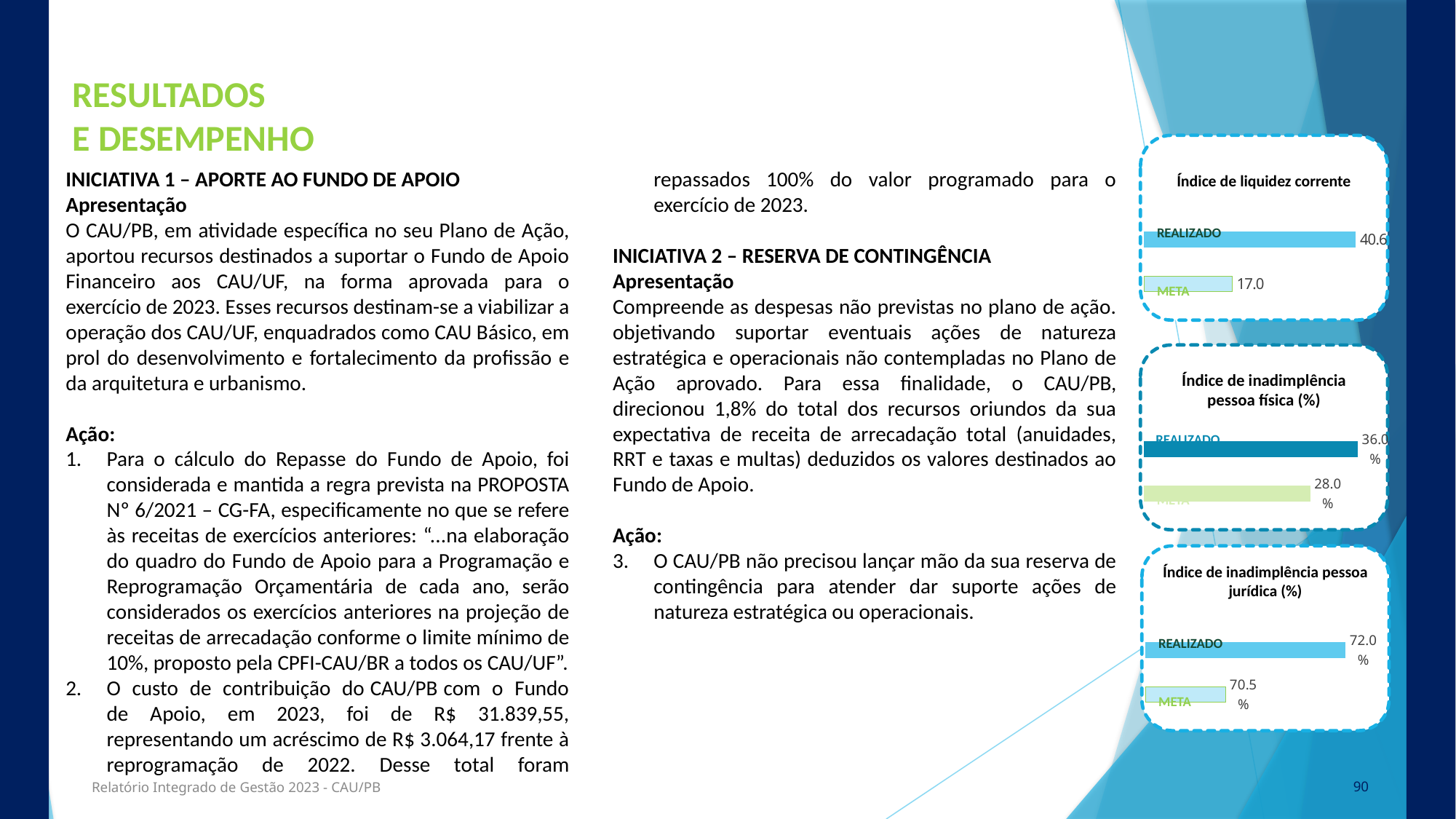
In the 'Índice de liquidez corrente' chart, what is the difference between REALIZADO and META? 23.6 In the 'Índice de inadimplência pessoa física (%)' chart, what is the value for META? 28.0% In the 'Índice de inadimplência pessoa física (%)' chart, what is the difference between REALIZADO and META? 8.0% What kind of chart is the 'Índice de liquidez corrente' chart? Bar chart In the 'Índice de inadimplência pessoa jurídica (%)' chart, what is the value for REALIZADO? 72.0% In the 'Índice de liquidez corrente' chart, what is the value for REALIZADO? 40.6 In the 'Índice de liquidez corrente' chart, what is the value for META? 17.0 In the 'Índice de inadimplência pessoa jurídica (%)' chart, what is the difference between REALIZADO and META? 1.5% In the 'Índice de inadimplência pessoa física (%)' chart, which is larger, REALIZADO or META? REALIZADO How many bars does the 'Índice de inadimplência pessoa jurídica (%)' chart show? 2 In the 'Índice de inadimplência pessoa jurídica (%)' chart, what is the value for META? 70.5% In the 'Índice de inadimplência pessoa física (%)' chart, what is the value for REALIZADO? 36.0%